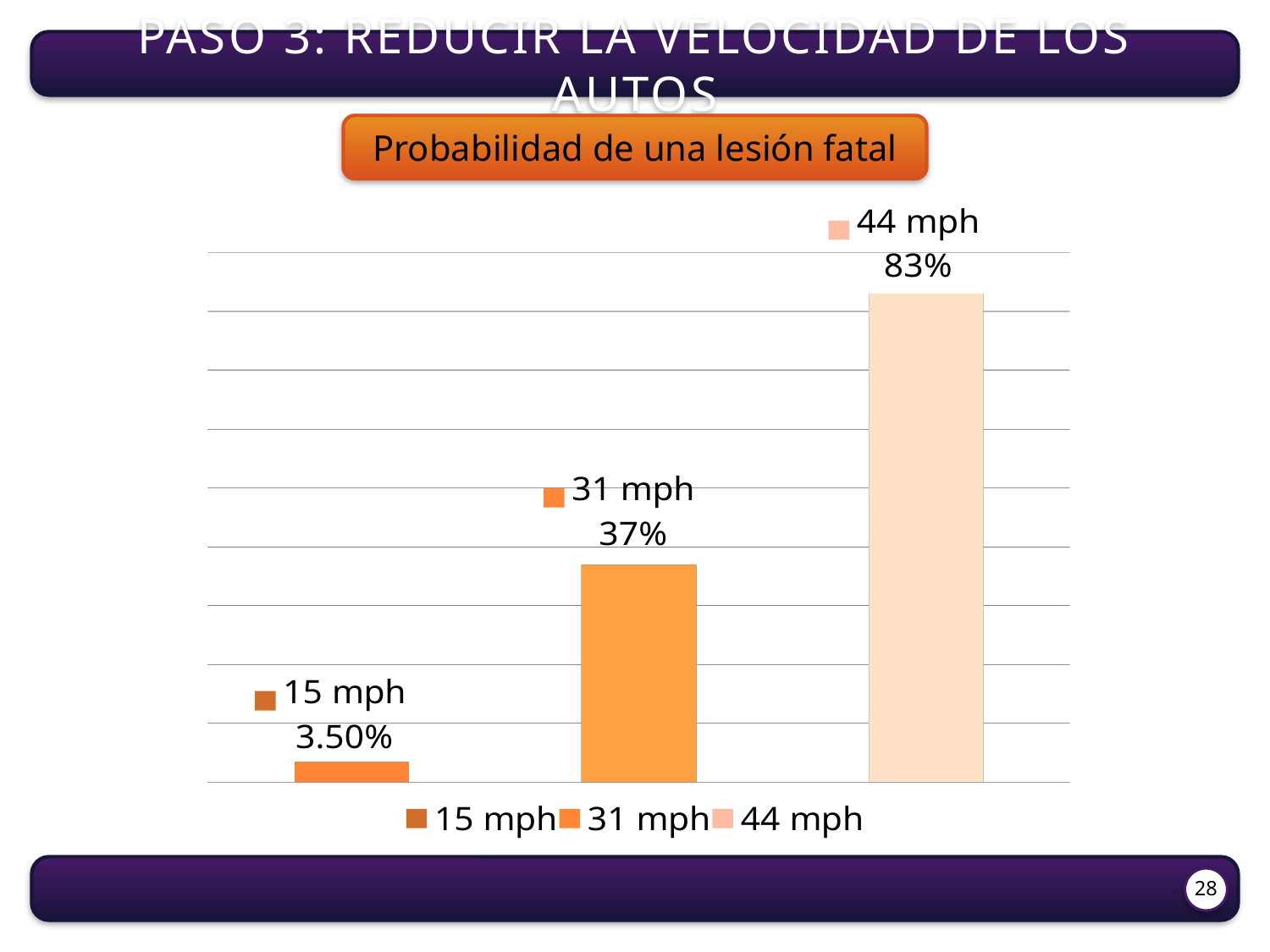
Which speed has the highest probability of a fatal injury? 44 mph Which speed has the lowest probability of a fatal injury? 15 mph Do the values rise or fall as speed increases from 15 mph to 44 mph? Rise What is the probability of a fatal injury at 44 mph? 83% What kind of chart is shown on the slide? Bar chart What is the difference between the probability at 31 mph and at 15 mph? 33.50% How many speed categories are shown in the chart? 3 What is the difference between the probability at 44 mph and at 31 mph? 46% What is the probability of a fatal injury at 15 mph? 3.50% How many entries does the legend list? 3 What is the probability of a fatal injury at 31 mph? 37% Which is larger, the probability at 31 mph or at 44 mph? 44 mph